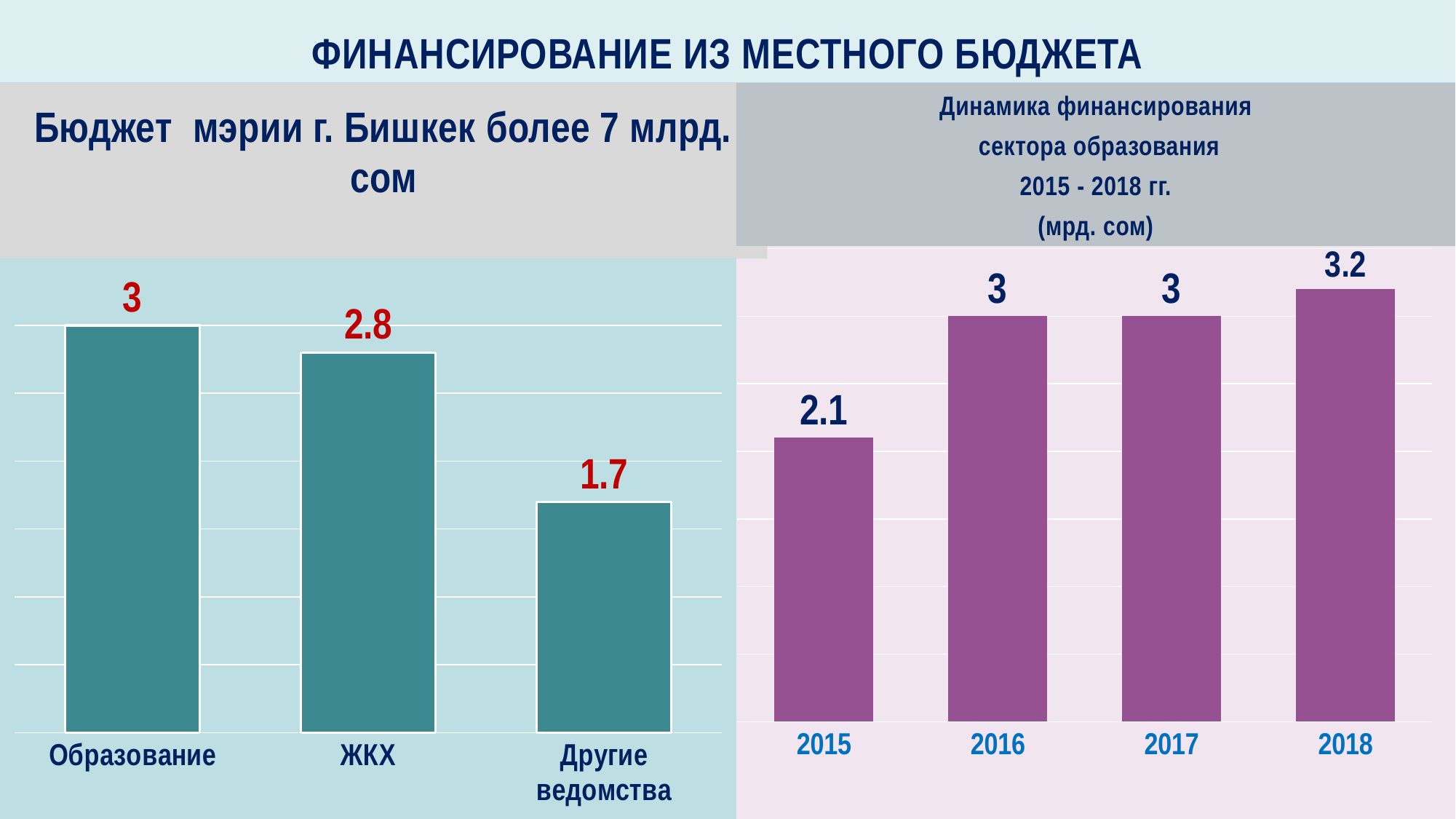
In the left chart (Бюджет мэрии г. Бишкек), what is the value for Образование? 3 In the left chart (Бюджет мэрии г. Бишкек), what is the value for Другие ведомства? 1.7 In the right chart (Динамика финансирования сектора образования), what is the difference between 2018 and 2015? 1.1 In the right chart (Динамика финансирования сектора образования), what is the value for 2018? 3.2 In the left chart (Бюджет мэрии г. Бишкек), what is the value for ЖКХ? 2.8 In the right chart (Динамика финансирования сектора образования), what is the value for 2015? 2.1 In the right chart (Динамика финансирования сектора образования), do the values generally rise or fall from 2015 to 2018? rise In the left chart (Бюджет мэрии г. Бишкек), which category has the lowest value? Другие ведомства In the left chart (Бюджет мэрии г. Бишкек), what is the difference between Образование and Другие ведомства? 1.3 What kind of chart is the right chart (Динамика финансирования сектора образования)? bar chart In the left chart (Бюджет мэрии г. Бишкек), how many categories are shown? 3 In the right chart (Динамика финансирования сектора образования), which year has the highest value? 2018